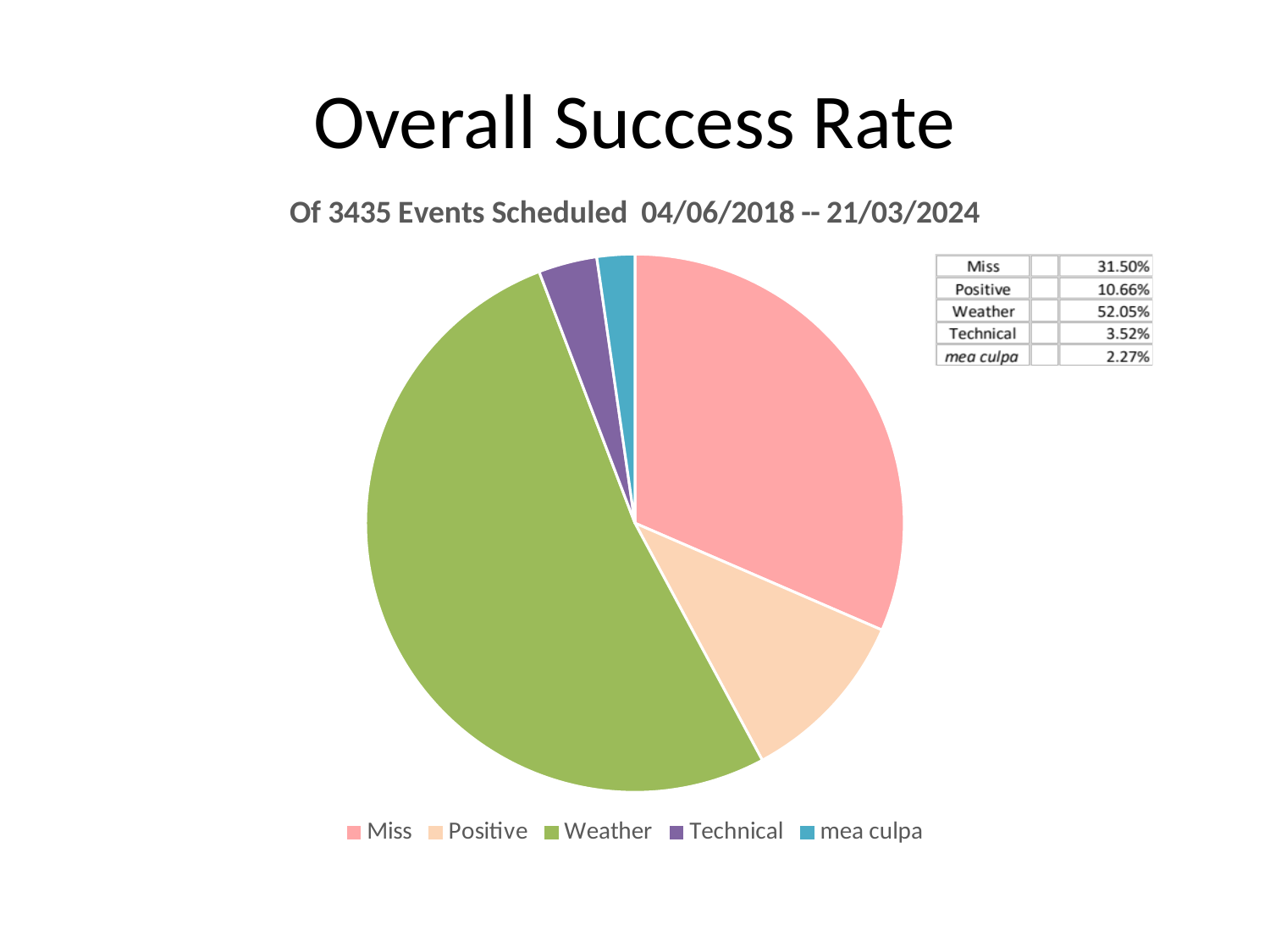
What is the chart's title? Of 3435 Events Scheduled 04/06/2018 -- 21/03/2024 Which category has the largest slice of the pie? Weather What kind of chart is shown on the slide? pie chart What percentage is shown for Positive? 10.66% Which category has the smallest slice of the pie? mea culpa What percentage is shown for Weather? 52.05% What percentage is shown for Miss? 31.50% What percentage is shown for Technical? 3.52% How many slices does the pie chart have? 5 What is the difference in percentage points between Weather and Miss? 20.55 What percentage is shown for mea culpa? 2.27% Which is larger, the Miss slice or the Positive slice? Miss